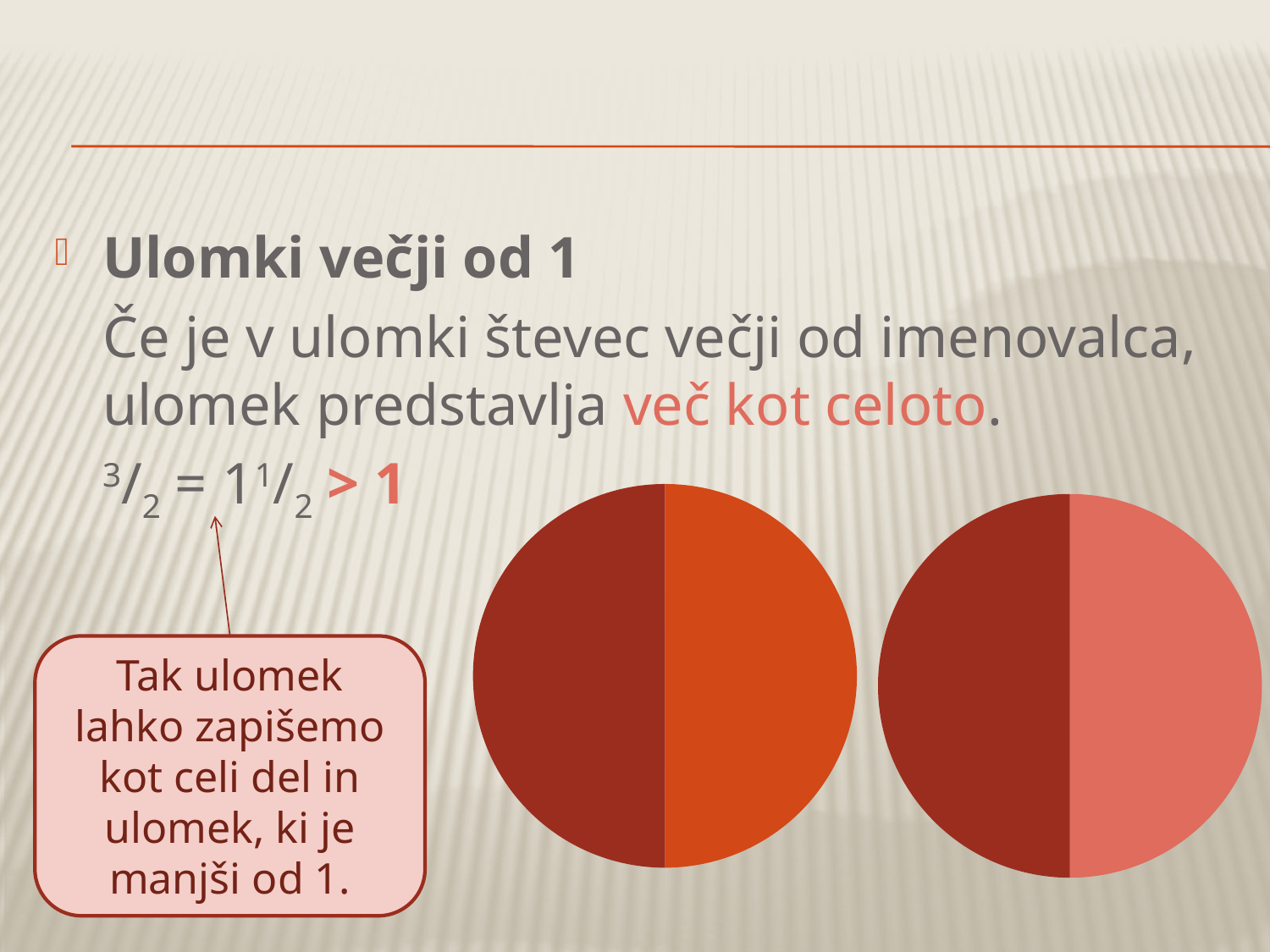
How many slices does the right pie chart have? 2 Which colour is the right-hand slice of the left pie chart, dark red or orange-red? orange-red What kind of chart is the left chart on the slide? pie chart What kind of chart is the right chart on the slide? pie chart In the right pie chart, are the two slices equal in size? yes Does either pie chart show a legend? no How many pie charts are shown on the slide? 2 How many slices does the left pie chart have? 2 In the left pie chart, are the two slices equal in size? yes